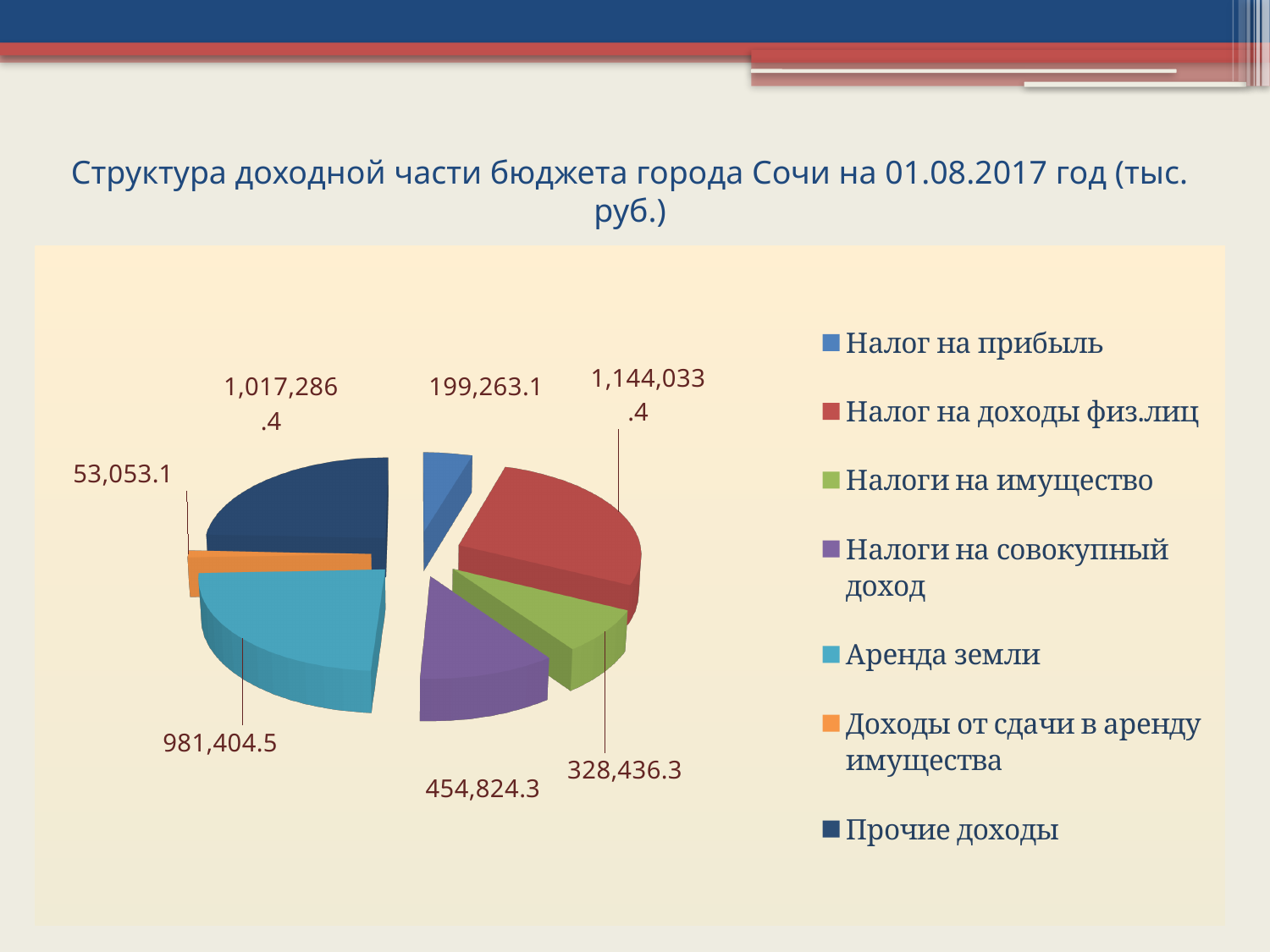
How many slices does the pie chart have? 7 Which category has the smallest value? Доходы от сдачи в аренду имущества What is the value for Доходы от сдачи в аренду имущества? 53,053.1 What colour is the slice for Налоги на имущество? Green Which category has the largest value? Налог на доходы физ.лиц What is the difference between Налог на доходы физ.лиц and Прочие доходы? 126,747.0 What is the difference between Налог на прибыль and Доходы от сдачи в аренду имущества? 146,210.0 What is the value for Налоги на совокупный доход? 454,824.3 Which is larger, Прочие доходы or Аренда земли? Прочие доходы What kind of chart is shown on the slide? Pie chart What is the value for Аренда земли? 981,404.5 What is the value for Налог на доходы физ.лиц? 1,144,033.4